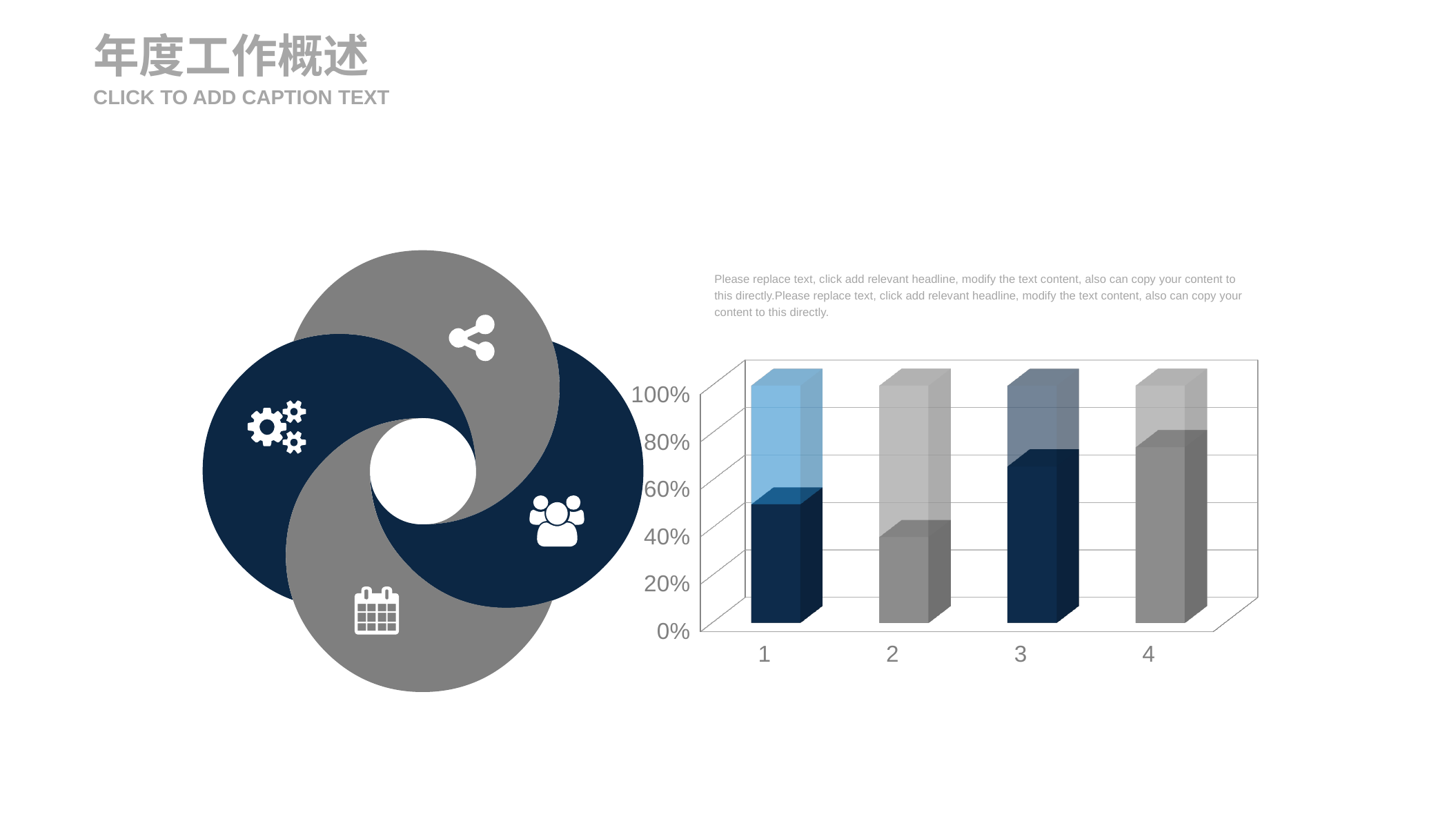
How many categories are shown on the x axis of the bar chart? 4 Which category has the lowest solid (dark) bar in the chart? 2 Which has the larger solid bar, category 1 or category 2? 1 Is the solid bar for category 2 greater or less than 60%? less Which category has the highest solid (dark) bar in the chart? 4 Does the solid bar value rise or fall from category 1 to category 2? fall Which has the larger solid bar, category 3 or category 2? 3 Is the solid bar for category 4 greater or less than 60%? greater What kind of chart is shown on the right side of the slide? bar chart What is the highest value labelled on the chart's vertical axis? 100% Is the solid bar for category 3 greater or less than 60%? greater